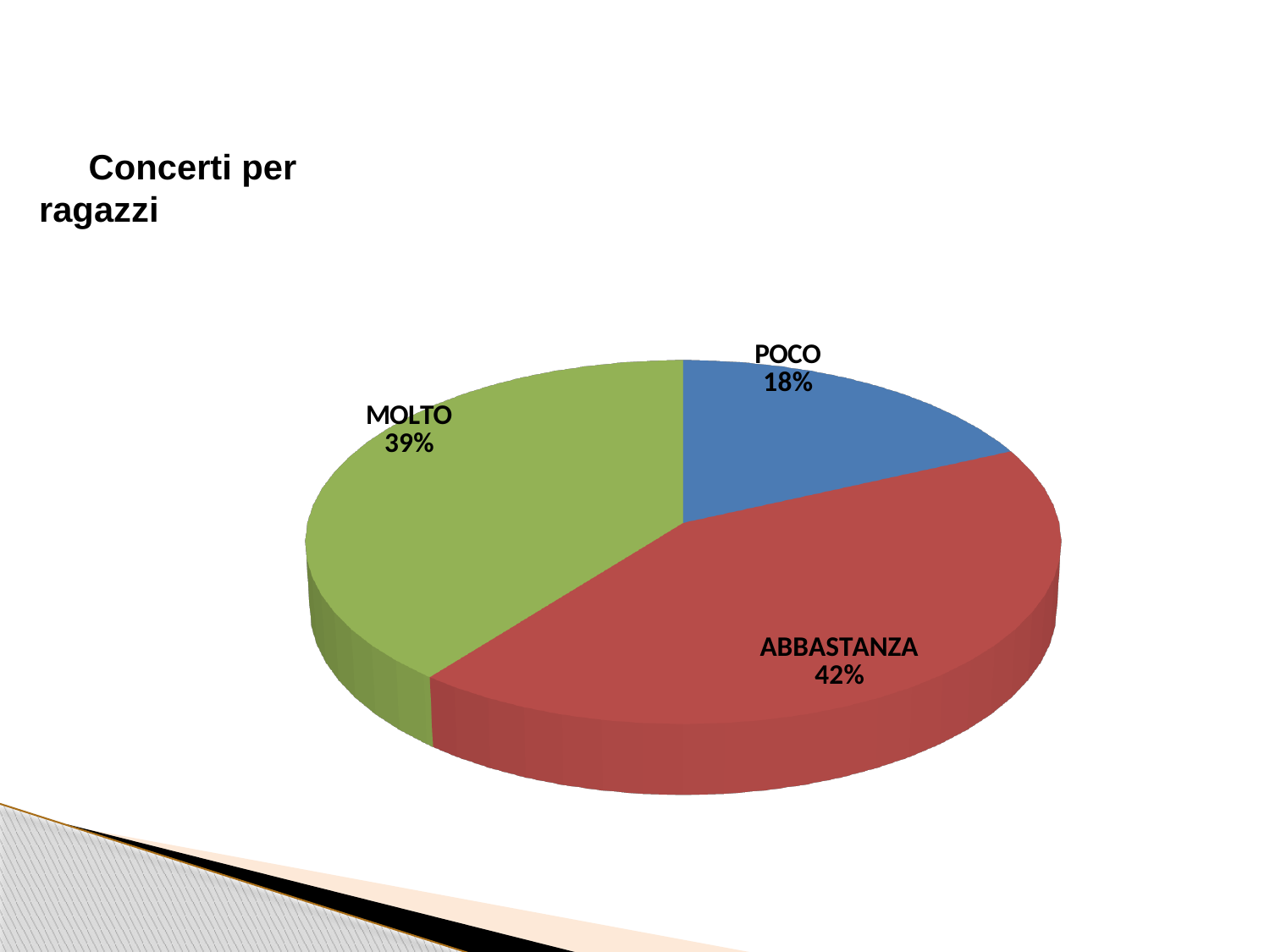
What kind of chart is shown on the slide? pie chart Which is larger, the MOLTO slice or the POCO slice? MOLTO What colour is the POCO slice? blue Which category has the largest share of the pie? ABBASTANZA What is the difference in percentage points between ABBASTANZA and POCO? 24 Which category has the smallest share of the pie? POCO What is the difference in percentage points between MOLTO and POCO? 21 What percentage does the POCO slice show? 18% What is the title text shown on the slide above the chart? Concerti per ragazzi What percentage does the MOLTO slice show? 39% What percentage does the ABBASTANZA slice show? 42% How many slices does the pie chart have? 3